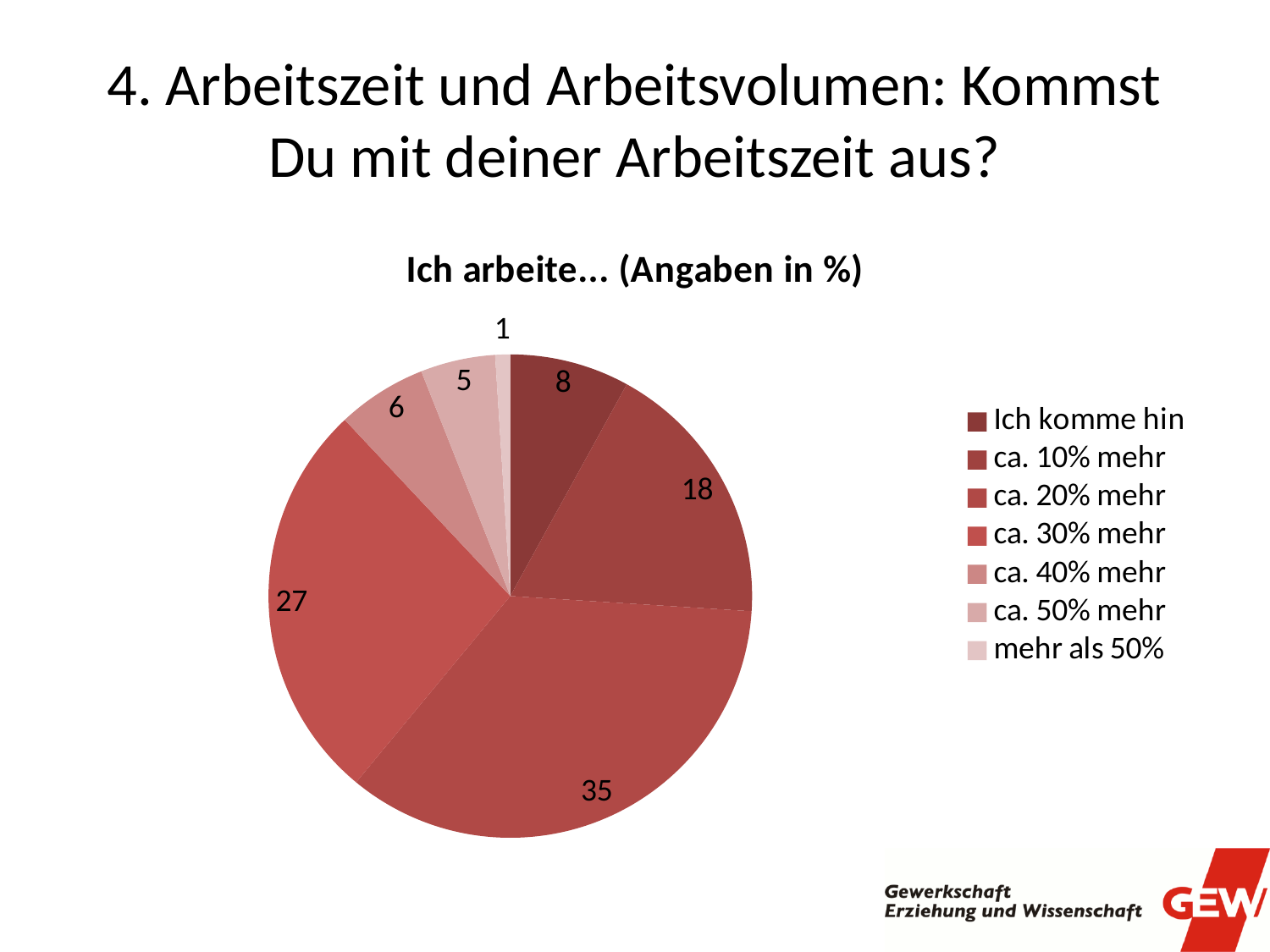
What is the title of the chart? Ich arbeite... (Angaben in %) What is the difference between the values for "ca. 40% mehr" and "ca. 50% mehr"? 1 What kind of chart is shown on the slide? pie chart What is the value for "Ich komme hin"? 8 Which category has the smallest slice? mehr als 50% What is the difference between the values for "ca. 20% mehr" and "ca. 30% mehr"? 8 What is the value for "mehr als 50%"? 1 How many categories does the legend list? 7 Which is larger, the value for "ca. 10% mehr" or the value for "Ich komme hin"? ca. 10% mehr What is the value for "ca. 30% mehr"? 27 Which category has the largest slice? ca. 20% mehr What is the value for "ca. 20% mehr"? 35